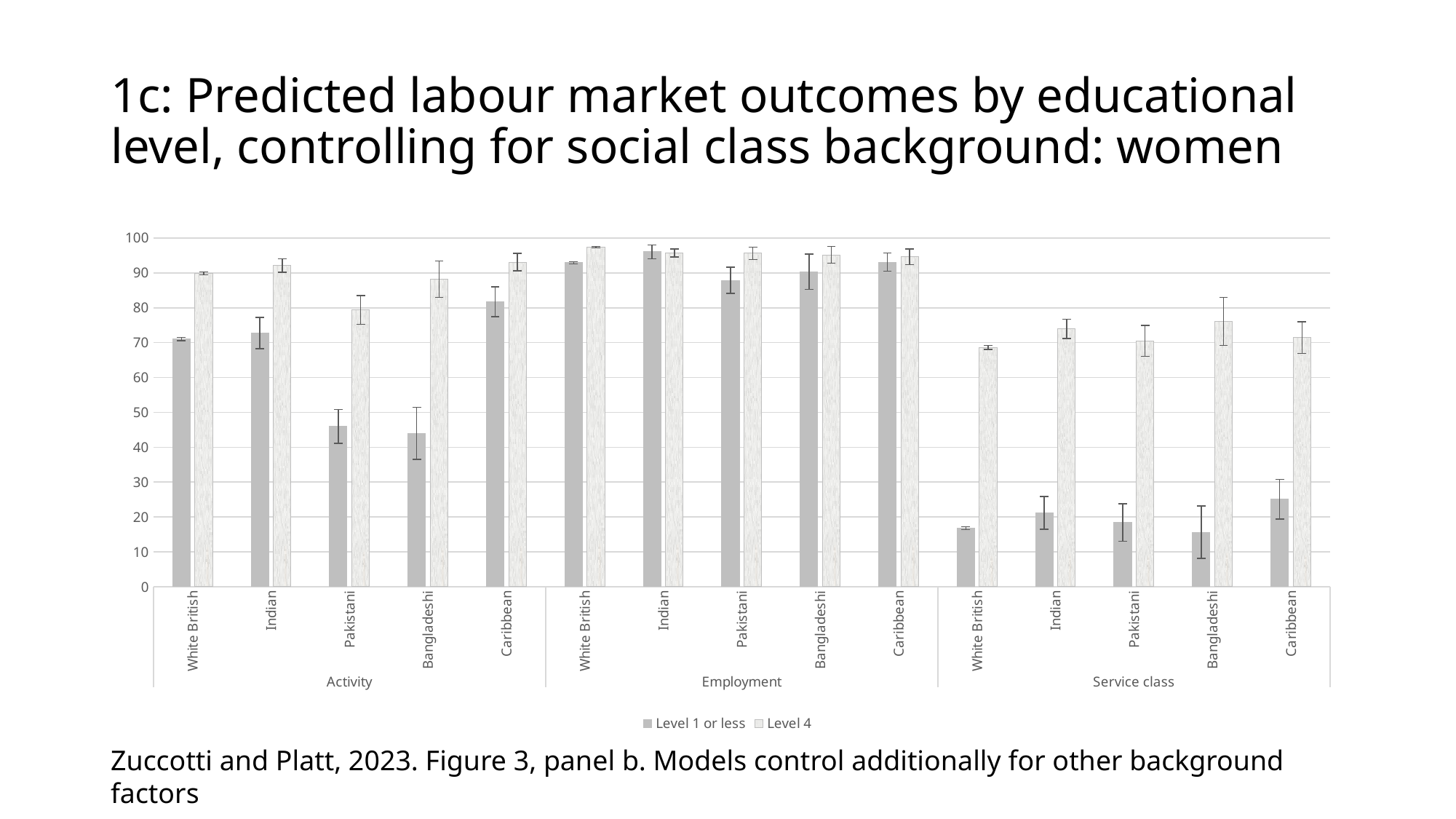
Is the Level 1 or less value for Pakistani women in the Activity group greater or less than 50? less Is the Level 1 or less value for Bangladeshi women in the Activity group greater or less than 40? greater Is the Level 1 or less value for Caribbean women in the Service class group greater or less than 30? less In the Activity group, which ethnic group has the highest Level 1 or less value? Caribbean What are the two series named in the legend? Level 1 or less; Level 4 In the Activity group, which is larger for Level 1 or less: Caribbean or Pakistani? Caribbean How many outcome groups are shown along the x axis? 3 What are the three outcome groups labelled on the x axis? Activity, Employment, Service class In the Service class group, which is larger for Level 4: Indian or White British? Indian How many series does the legend list? 2 What kind of chart is shown on the slide? bar chart